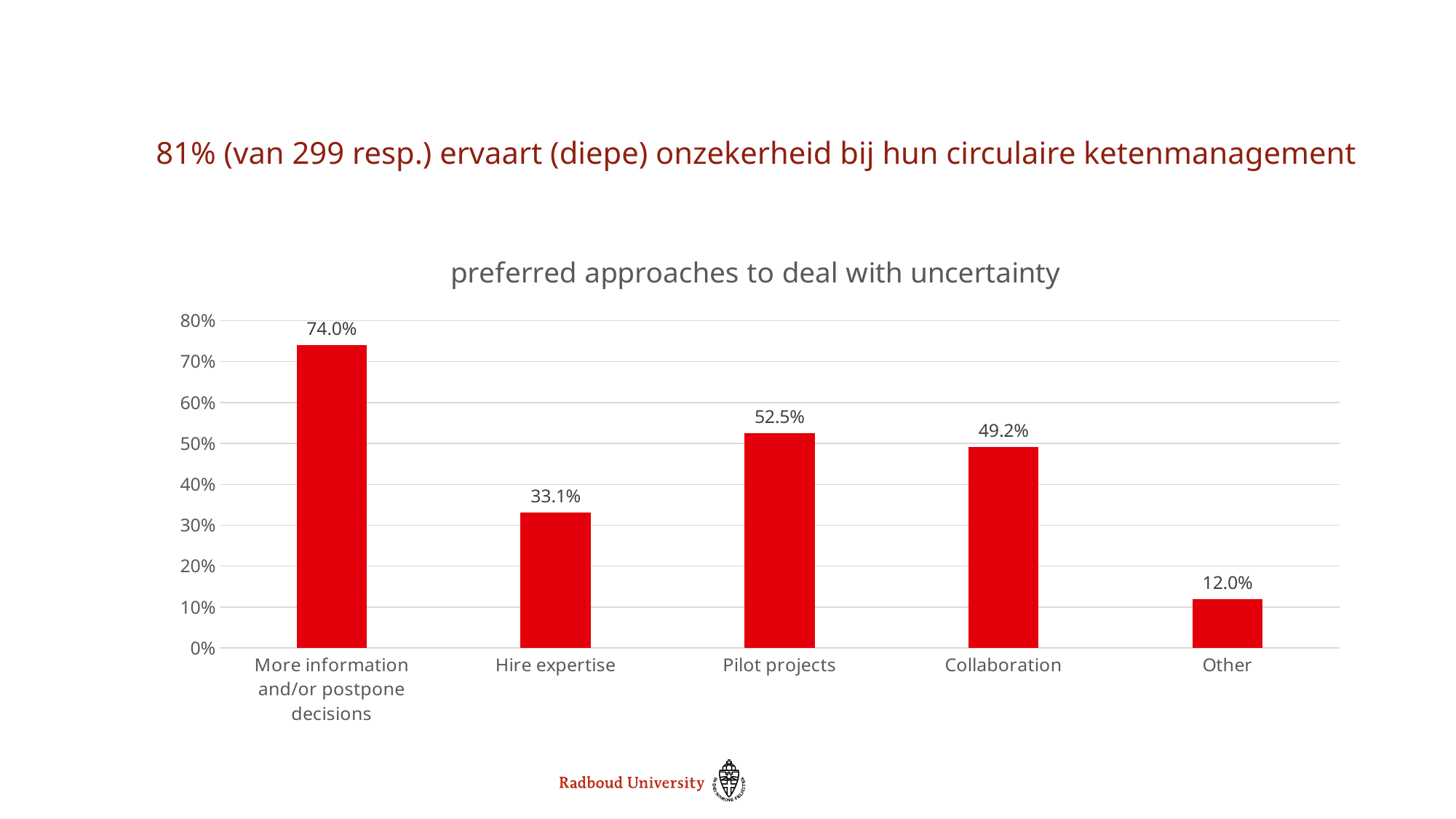
Which category has the lowest value? Other What is the difference between the values for More information and/or postpone decisions and Collaboration? 24.8% Which category has the highest value? More information and/or postpone decisions What is the value for Other? 12.0% What is the title of the chart? preferred approaches to deal with uncertainty What kind of chart is shown on the slide? bar chart Is the value for Hire expertise greater or less than 40%? less How many categories are shown on the x axis? 5 What colour are the bars in the chart? red What is the value for Hire expertise? 33.1% What is the value for Pilot projects? 52.5% Which is larger, the value for Pilot projects or the value for Collaboration? Pilot projects